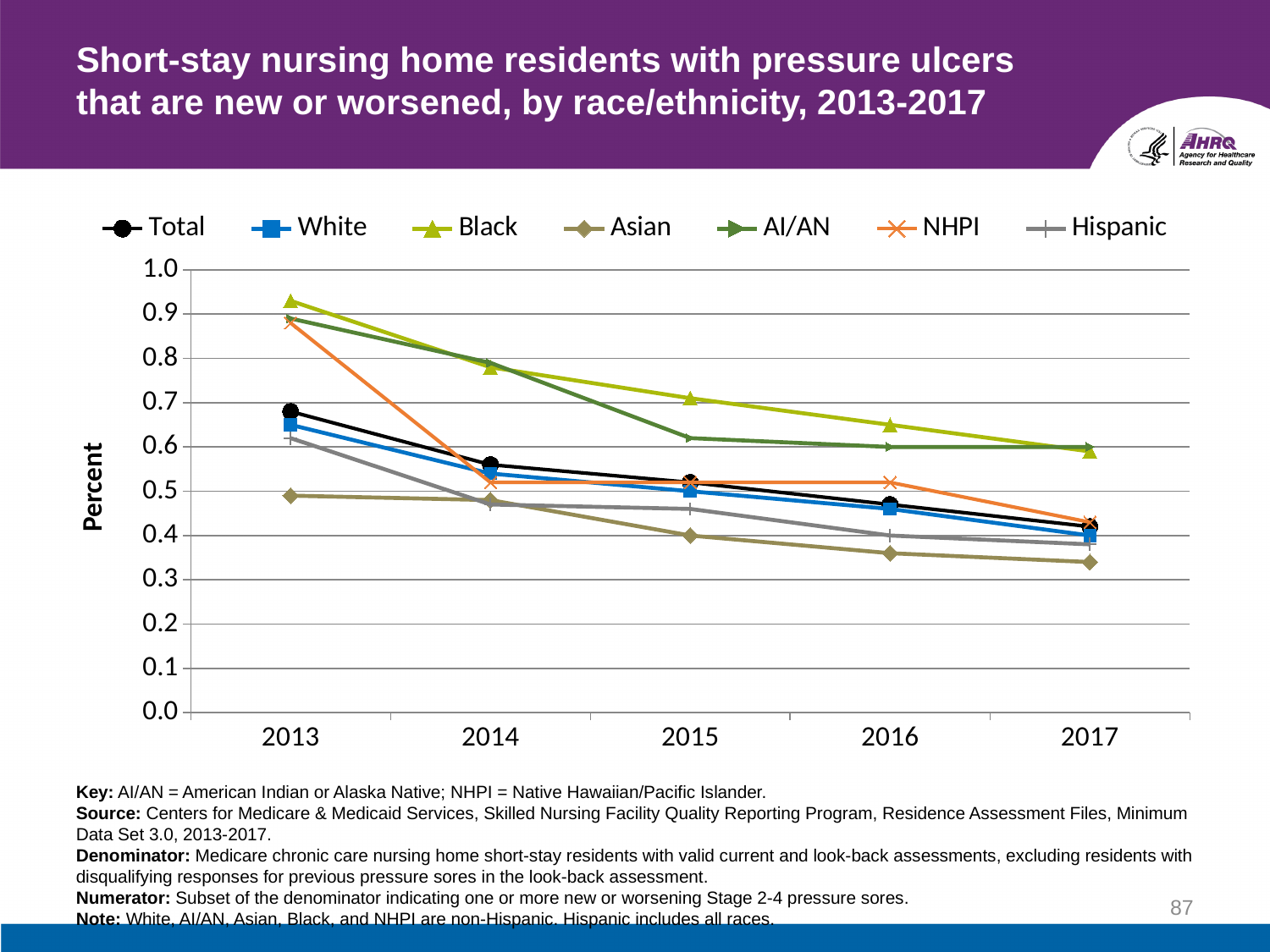
Is the value for Black in 2016 greater or less than 0.6? greater Does the Total line rise or fall from 2013 to 2017? Fall Is the value for Total in 2017 greater or less than 0.5? less What kind of chart is shown on the slide? Line chart Which race/ethnicity group has the highest value in 2013? Black Is the value for Asian in 2017 greater or less than 0.4? less How many series does the legend list? 7 In 2015, which is larger, the value for Black or the value for Hispanic? Black Which race/ethnicity group has the lowest value in 2017? Asian Which race/ethnicity group has the lowest value in 2013? Asian How many years are plotted along the x axis? 5